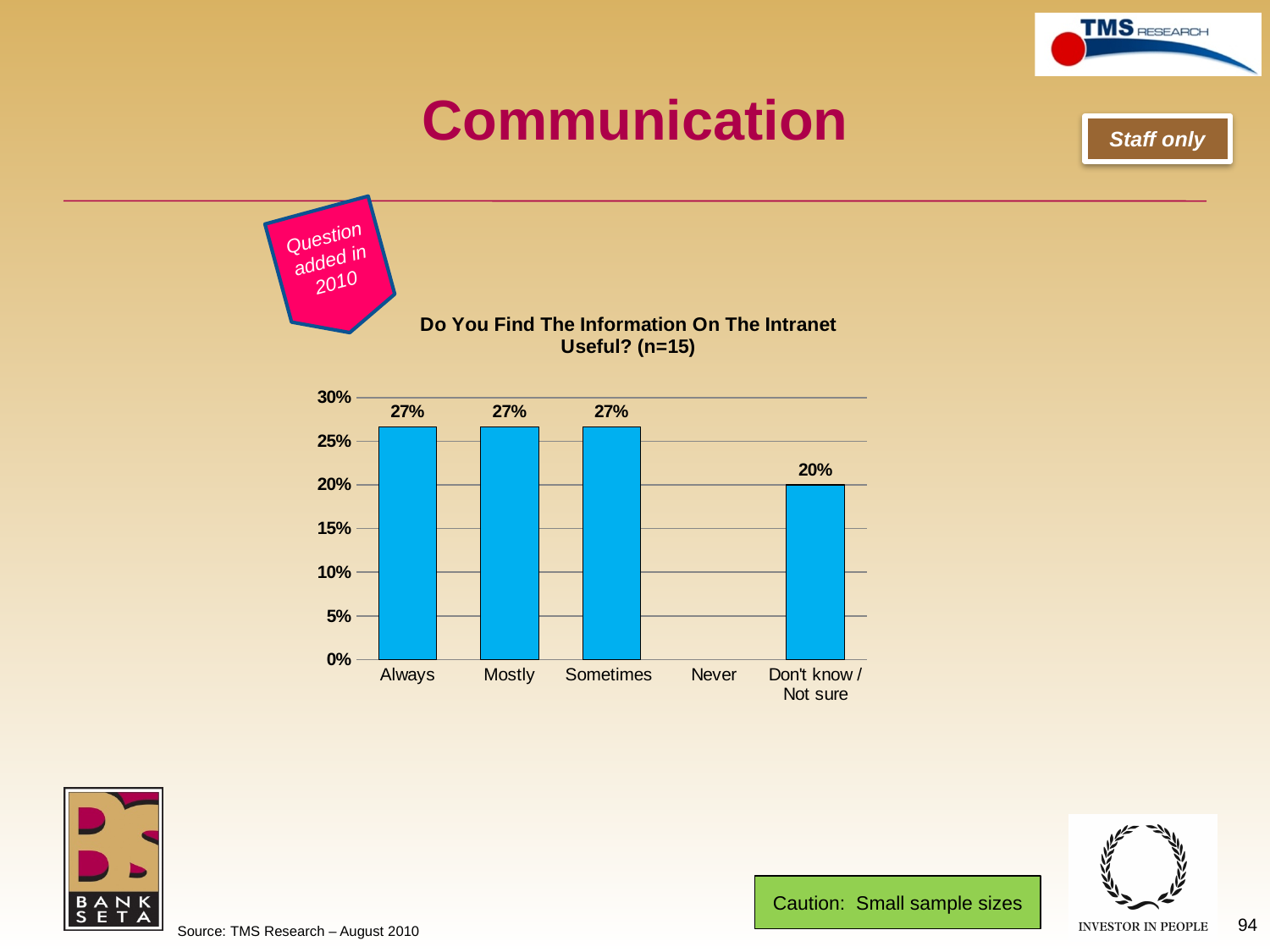
What is the sample size (n) given in the chart title? 15 Is the value for Always greater or less than 25%? greater What is the value for Sometimes? 27% How many categories are shown on the x axis? 5 What is the highest value shown on the y axis? 30% Which category has no visible bar? Never What is the difference between the values for Mostly and Don't know / Not sure? 7% What is the value for Always? 27% Which is larger, the value for Sometimes or the value for Don't know / Not sure? Sometimes Which category has the lowest value among those with a visible bar? Don't know / Not sure What kind of chart is shown? bar chart What is the value for Don't know / Not sure? 20%